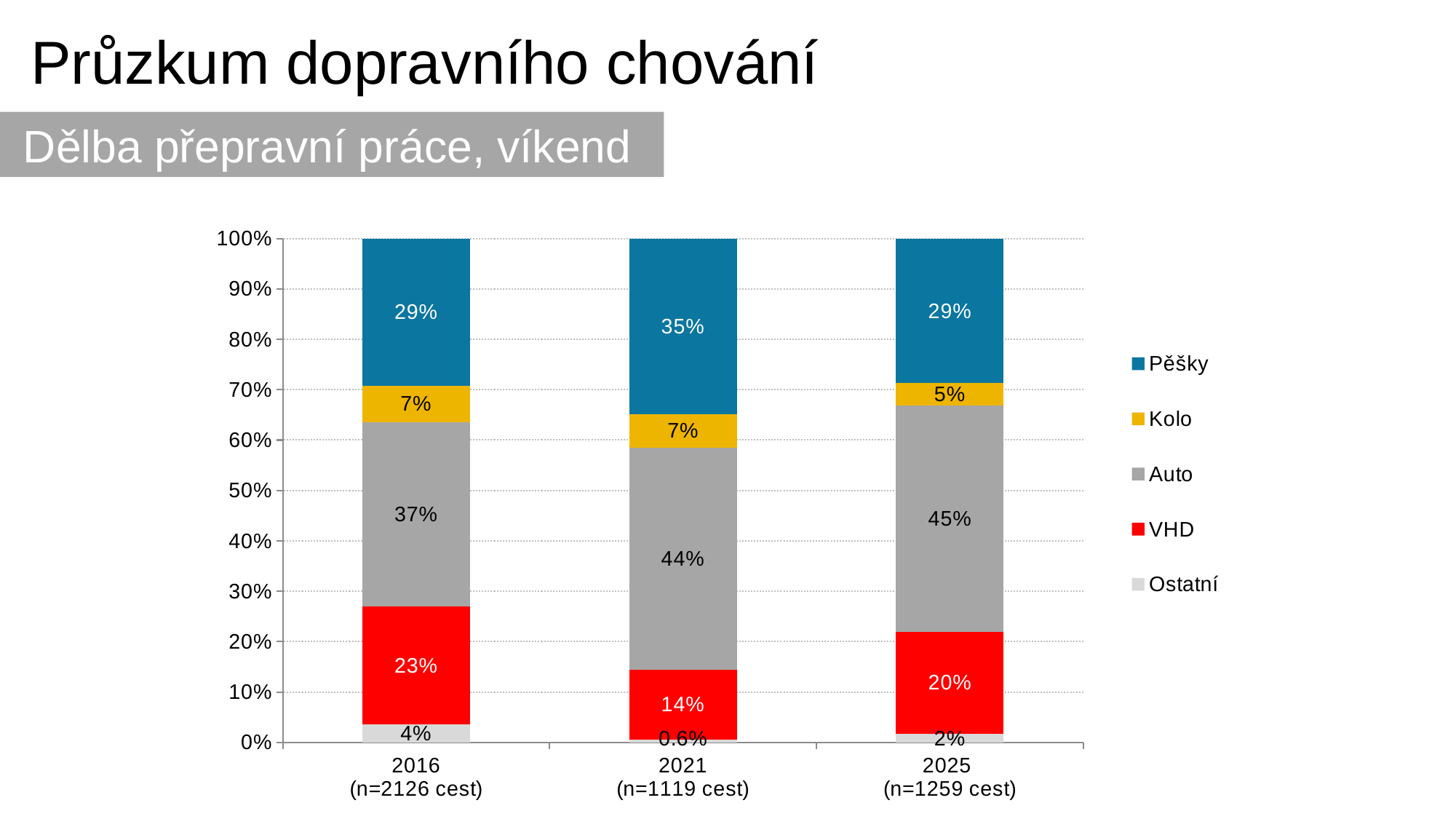
What is the share of Kolo in 2025? 5% What is the difference between the Auto share in 2025 and in 2016? 8% What type of chart is shown on the slide? stacked bar chart How does the Auto share change from 2016 to 2025? rises What is the share of VHD in 2016? 23% What is the share of Auto in 2021? 44% Which is larger in 2025: the share of Auto or the share of Pěšky? Auto In which year is the Pěšky share highest? 2021 What is the share of Ostatní in 2021? 0.6% In which year is the VHD share lowest? 2021 How many years (categories) are shown on the x axis? 3 How many series does the legend list? 5